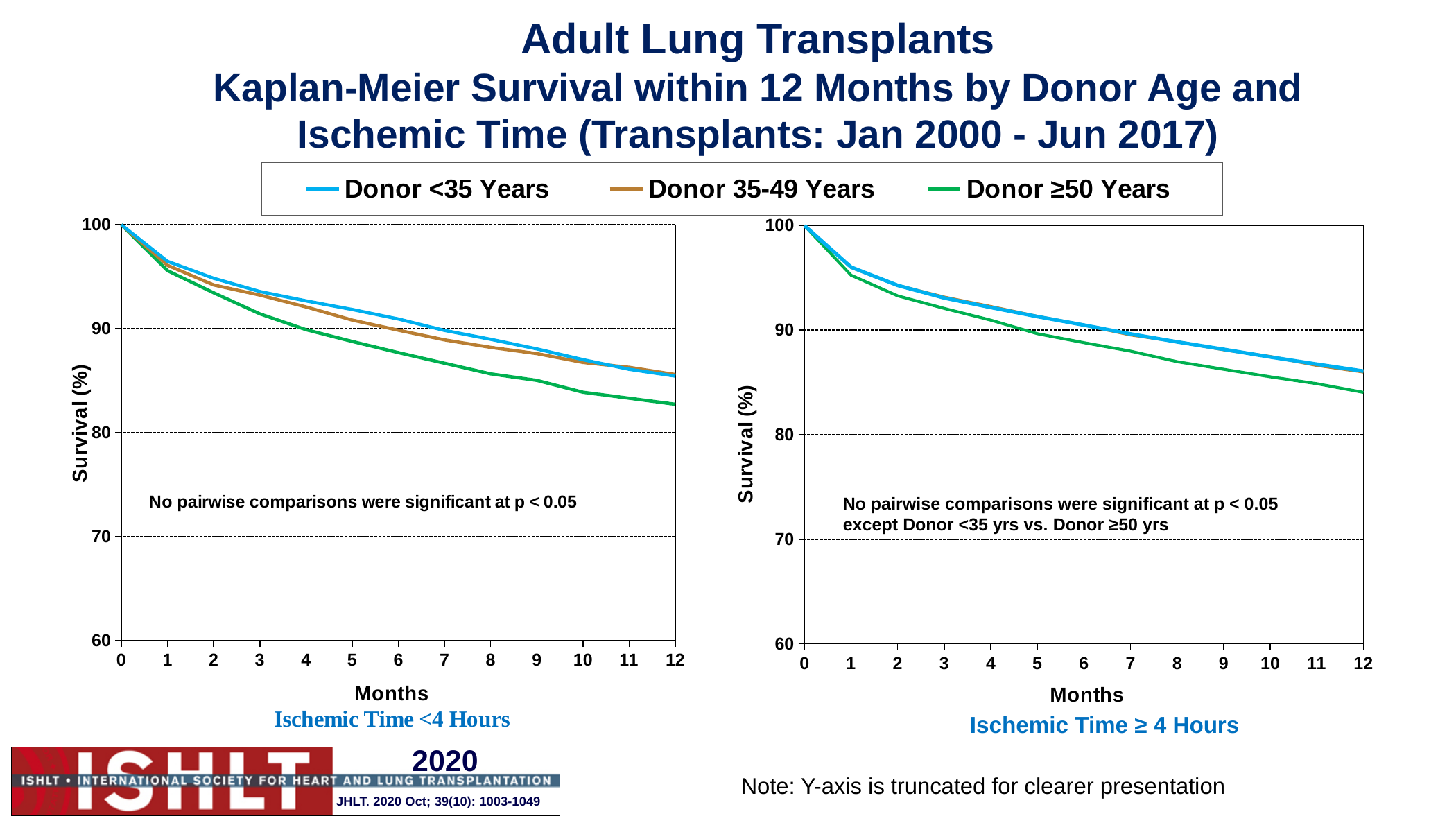
In the Ischemic Time <4 Hours chart, do the survival curves rise or fall as months increase? Fall Which colour represents Donor 35-49 Years in the legend? Brown What type of chart is used on this slide? Line chart In the Ischemic Time <4 Hours chart, which donor age group has the lowest survival at 12 months? Donor ≥50 Years In the Ischemic Time ≥ 4 Hours chart, is the survival for Donor ≥50 Years at 12 months greater or less than 80? greater What is the label on the y-axis of both charts? Survival (%) In the Ischemic Time ≥ 4 Hours chart, is the survival for Donor <35 Years at 4 months greater or less than 90? greater In the Ischemic Time <4 Hours chart, is the survival for Donor ≥50 Years at 12 months greater or less than 90? less In the Ischemic Time <4 Hours chart, which has higher survival at 6 months: Donor <35 Years or Donor ≥50 Years? Donor <35 Years How many series does the legend list? 3 In the Ischemic Time ≥ 4 Hours chart, which donor age group has the lowest survival at 12 months? Donor ≥50 Years What is the survival (%) for all donor age groups at month 0 in the Ischemic Time ≥ 4 Hours chart? 100